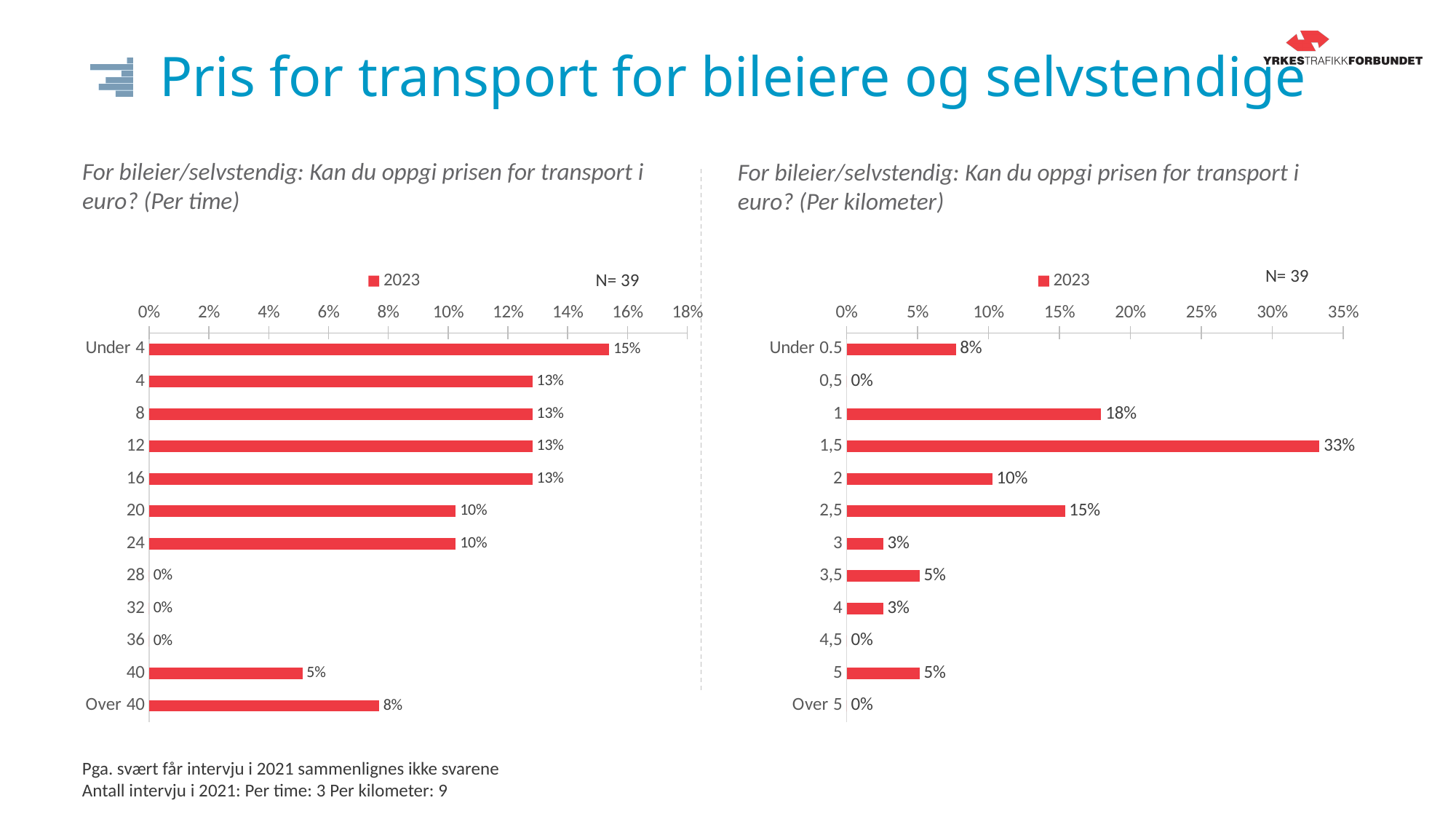
In the right chart (Per kilometer), what is the value for '1,5'? 33% In the right chart (Per kilometer), which category has the highest value? 1,5 In the right chart (Per kilometer), what is the difference between the values for '1,5' and '1'? 15% In the left chart (Per time), which category has the highest value? Under 4 How many series does the legend of the left chart (Per time) list? 1 What type of chart is the right chart (Per kilometer)? Bar chart In the right chart (Per kilometer), which is larger, the value for '1' or the value for '2'? 1 In the left chart (Per time), what is the difference between the values for 'Under 4' and '40'? 10% In the left chart (Per time), what is the value for 'Under 4'? 15% In the right chart (Per kilometer), what is the value for '2,5'? 15% In the left chart (Per time), what is the value for 'Over 40'? 8% In the left chart (Per time), how many categories are shown on the vertical axis? 12